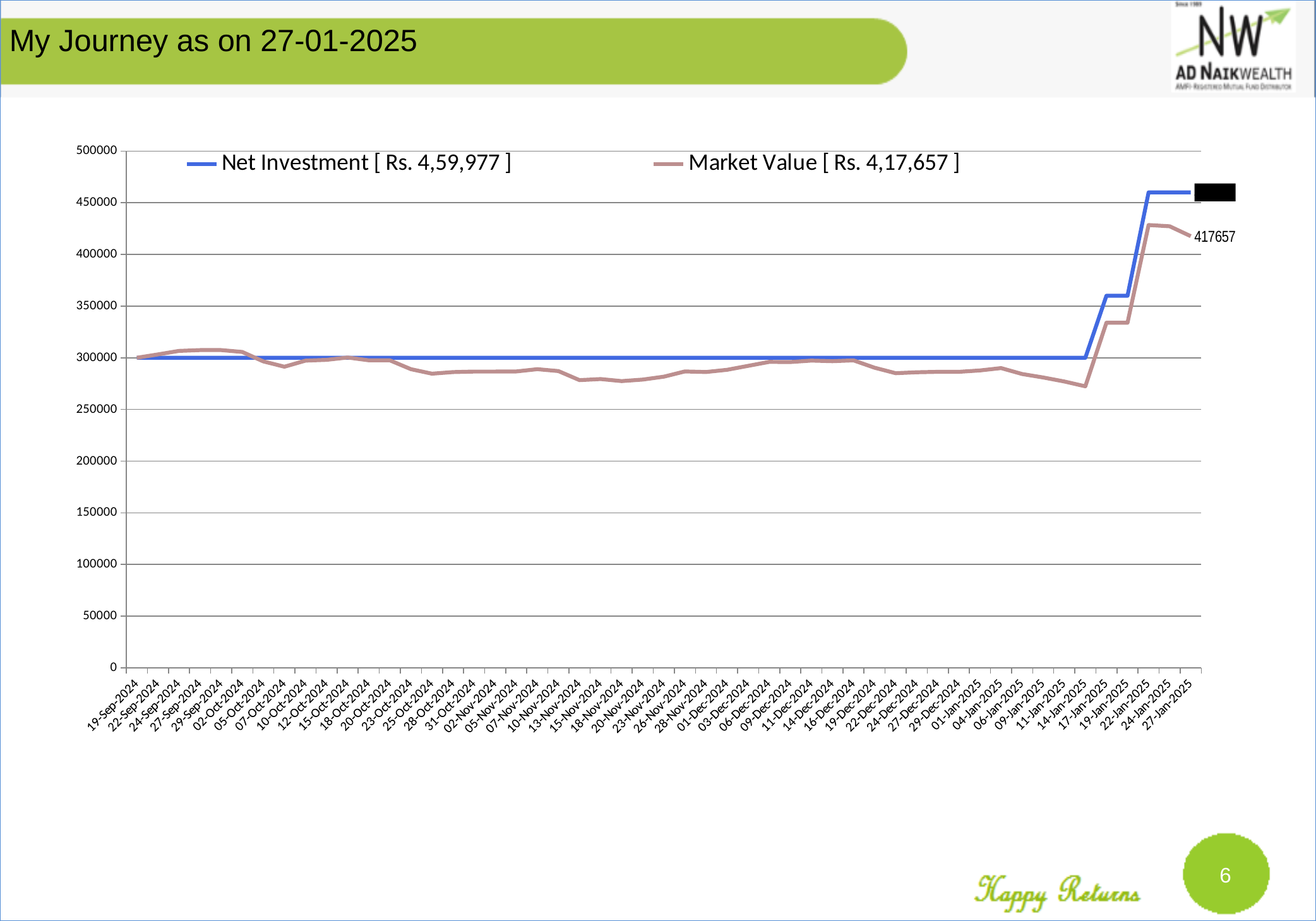
Does the Net Investment line rise or fall overall from 19-Sep-2024 to 27-Jan-2025? rise Is the Net Investment value on 27-Jan-2025 greater or less than 450000? greater On 27-Jan-2025, which is larger: Net Investment or Market Value? Net Investment How many series does the chart legend list? 2 Using the amounts in the legend, what is the difference between Net Investment and Market Value? Rs. 42,320 What Market Value amount is shown in the chart legend? Rs. 4,17,657 Is the Market Value on 22-Jan-2025 greater or less than 400000? greater What Net Investment amount is shown in the chart legend? Rs. 4,59,977 Is the Market Value on 14-Jan-2025 greater or less than 300000? less What is the Market Value on 27-Jan-2025 according to the data label at the end of the line? 417657 What is the title of the slide containing the chart? My Journey as on 27-01-2025 What kind of chart is shown on the slide? line chart